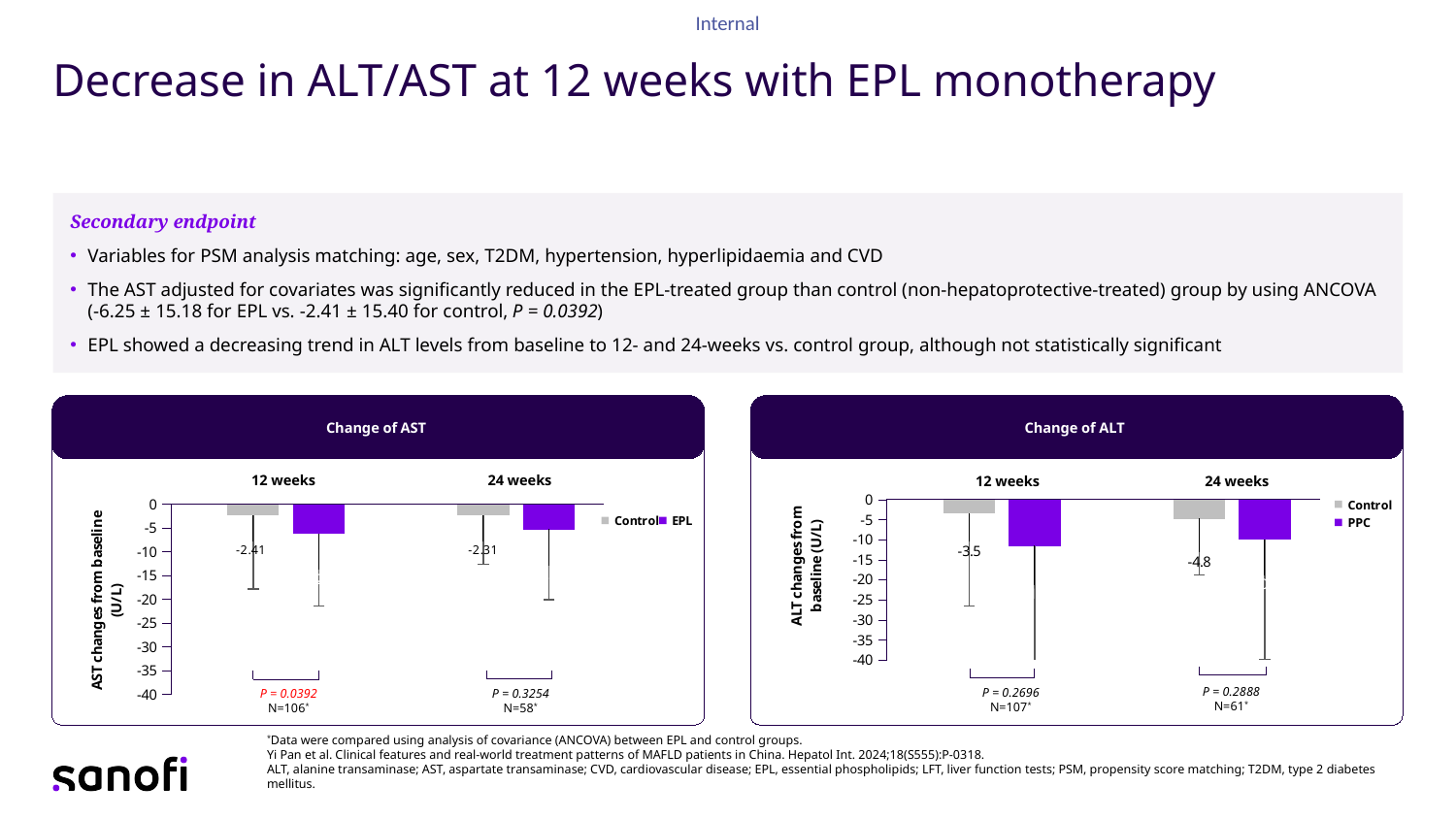
In the 'Change of ALT' chart, what is the value for Control at 12 weeks? -3.5 In the 'Change of AST' chart, what P value is shown under the 12 weeks bars? P = 0.0392 In the 'Change of ALT' chart, how many time points are shown on the x axis? 2 In the 'Change of AST' chart, what is the value for Control at 12 weeks? -2.41 In the 'Change of ALT' chart, is the value for PPC at 12 weeks greater or less than -10? less In the 'Change of AST' chart, how many series does the legend list? 2 What kind of chart is the 'Change of AST' chart? bar chart In the 'Change of AST' chart, what is the value for Control at 24 weeks? -2.31 In the 'Change of ALT' chart, what is the value for Control at 24 weeks? -4.8 In the 'Change of ALT' chart, what are the two series named in the legend? Control and PPC In the 'Change of AST' chart at 12 weeks, which series shows the larger decrease from baseline, Control or EPL? EPL In the 'Change of AST' chart, is the value for EPL at 12 weeks greater or less than -5? less